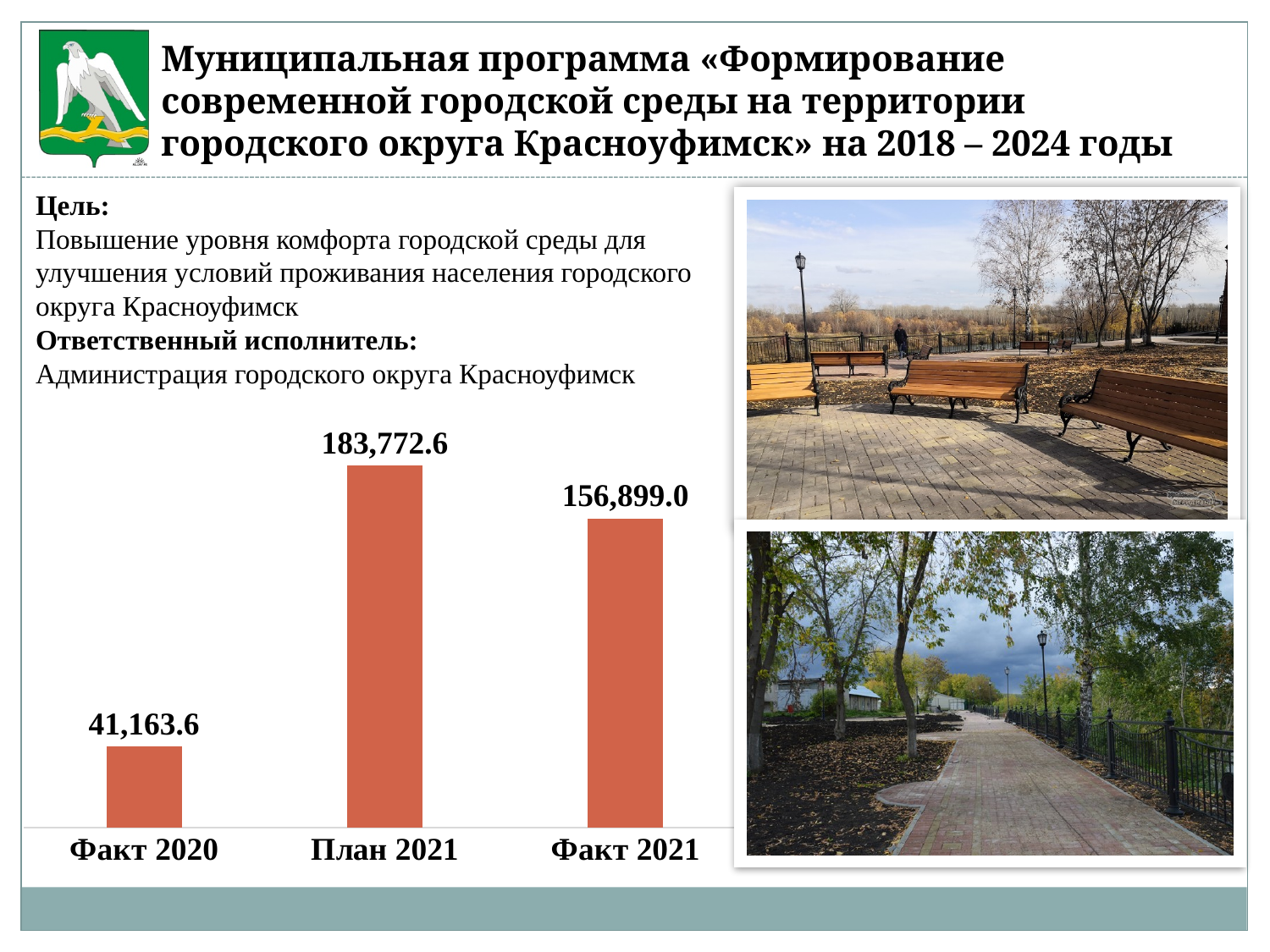
Which is larger, the value for План 2021 or the value for Факт 2021? План 2021 What kind of chart is shown on the slide? Bar chart What is the value for План 2021 on the chart? 183,772.6 What is the value for Факт 2020 on the chart? 41,163.6 How many categories are shown on the chart? 3 Does the value rise or fall from План 2021 to Факт 2021? Fall Which category has the highest value on the chart? План 2021 What is the difference between the values for Факт 2021 and Факт 2020? 115,735.4 What is the value for Факт 2021 on the chart? 156,899.0 What is the difference between the values for План 2021 and Факт 2021? 26,873.6 What is the difference between the values for План 2021 and Факт 2020? 142,609.0 Which category has the lowest value on the chart? Факт 2020